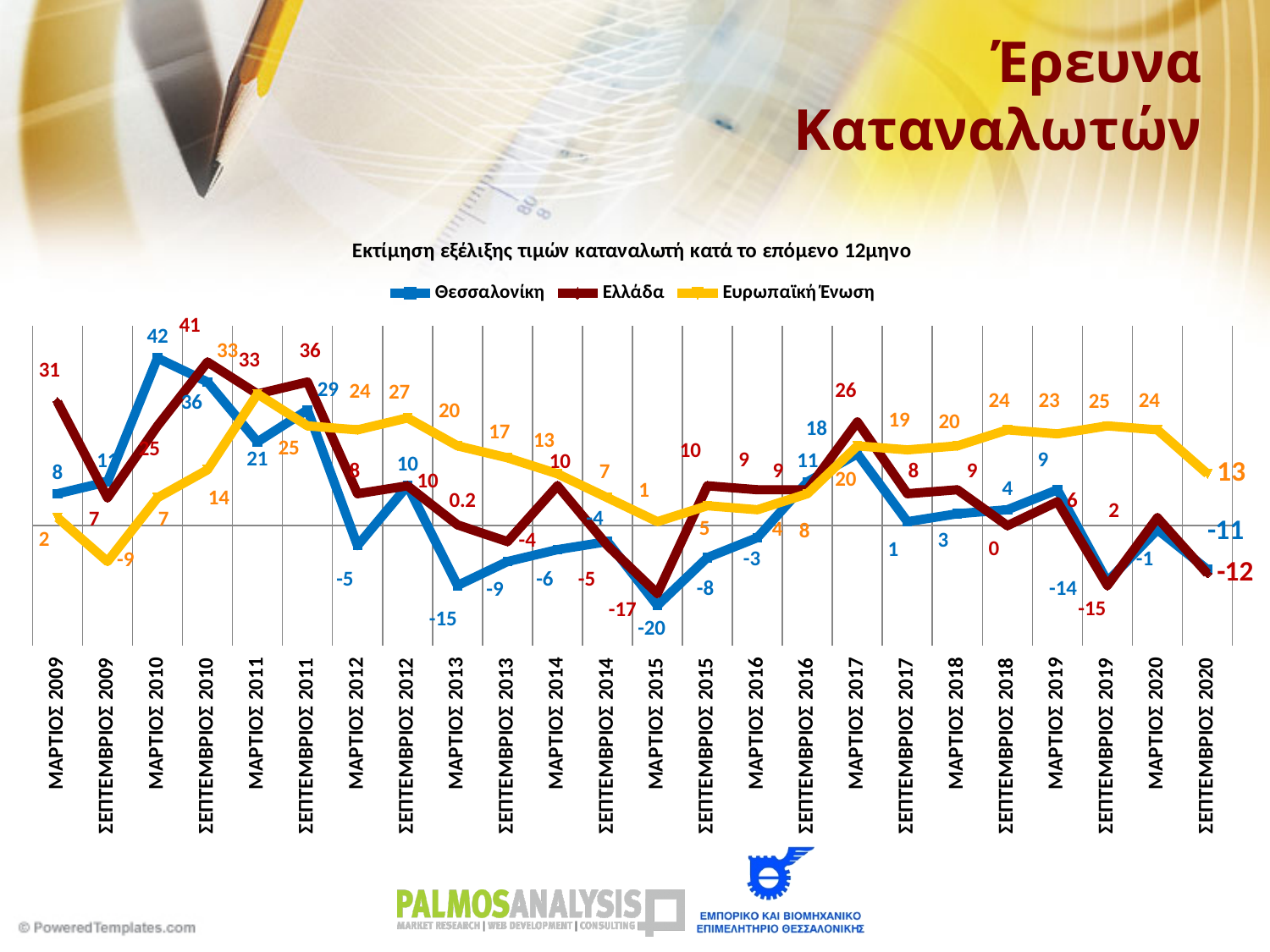
What is the title of the chart? Εκτίμηση εξέλιξης τιμών καταναλωτή κατά το επόμενο 12μηνο How many series does the legend list? 3 What is the difference between Θεσσαλονίκη and Ελλάδα in ΜΑΡΤΙΟΣ 2010? 17 Which series has the higher value in ΣΕΠΤΕΜΒΡΙΟΣ 2019, Ευρωπαϊκή Ένωση or Ελλάδα? Ευρωπαϊκή Ένωση In which period does Ελλάδα reach its highest value? ΣΕΠΤΕΜΒΡΙΟΣ 2010 What kind of chart is shown on the slide? Line chart In which period does Ευρωπαϊκή Ένωση reach its lowest value? ΣΕΠΤΕΜΒΡΙΟΣ 2009 How many time points are plotted along the x axis? 24 What is the value for Ελλάδα in ΜΑΡΤΙΟΣ 2009? 31 What is the value for Θεσσαλονίκη in ΜΑΡΤΙΟΣ 2010? 42 In which period does Θεσσαλονίκη reach its lowest value? ΜΑΡΤΙΟΣ 2015 What is the value for Ευρωπαϊκή Ένωση in ΣΕΠΤΕΜΒΡΙΟΣ 2020? 13